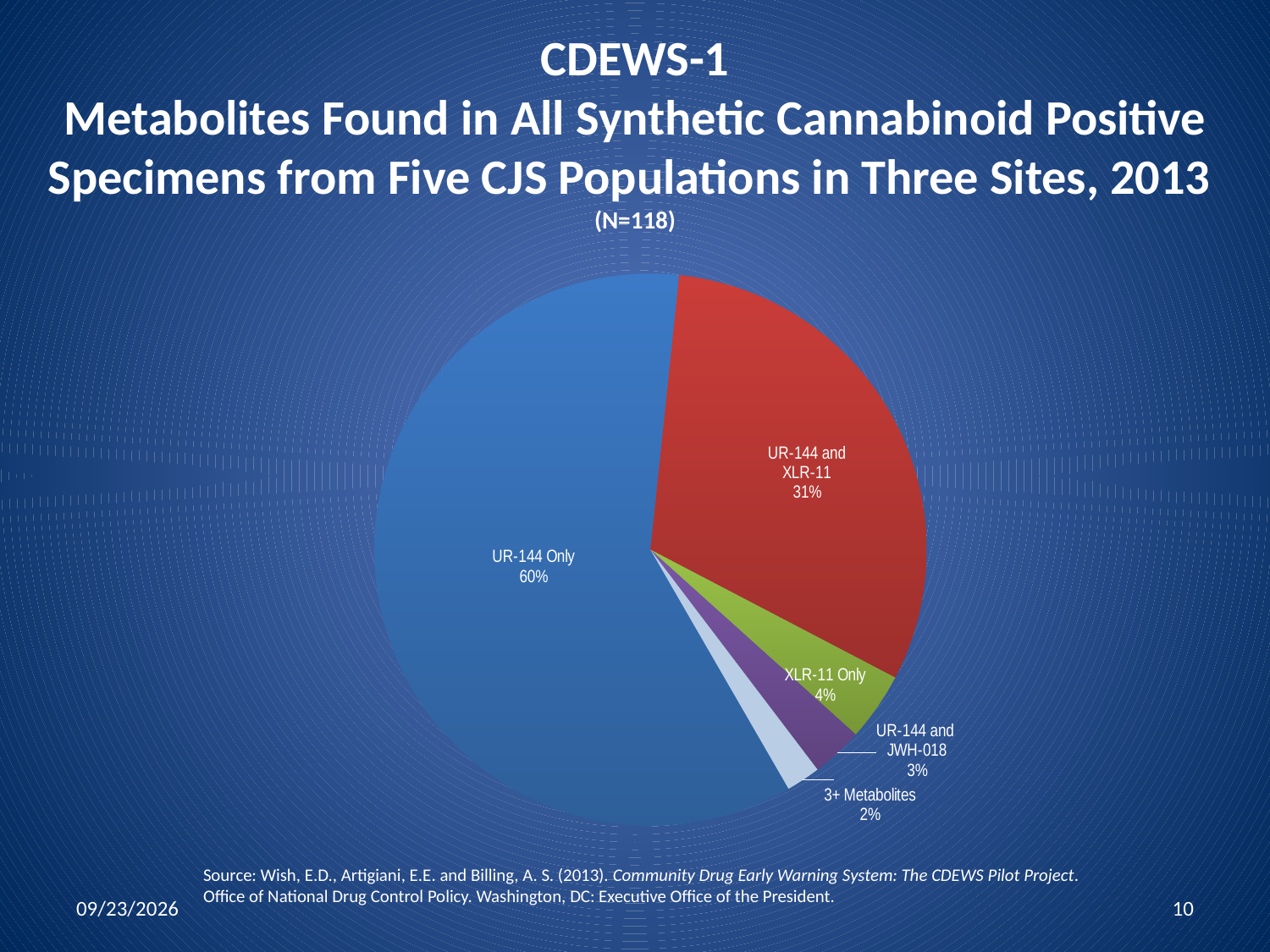
What share of specimens contained UR-144 Only? 60% What percentage of specimens contained UR-144 and JWH-018? 3% What kind of chart is shown on the slide? Pie chart What percentage of specimens contained 3+ Metabolites? 2% What percentage of specimens contained both UR-144 and XLR-11? 31% Which metabolite category accounts for the smallest share of the pie? 3+ Metabolites What percentage of specimens contained XLR-11 Only? 4% What is the difference in percentage points between UR-144 Only and UR-144 and XLR-11? 29 What is the sample size (N) stated under the chart title? 118 How many slices does the pie chart have? 5 Which metabolite category accounts for the largest share of the pie? UR-144 Only Which is larger: the share for XLR-11 Only or the share for UR-144 and JWH-018? XLR-11 Only